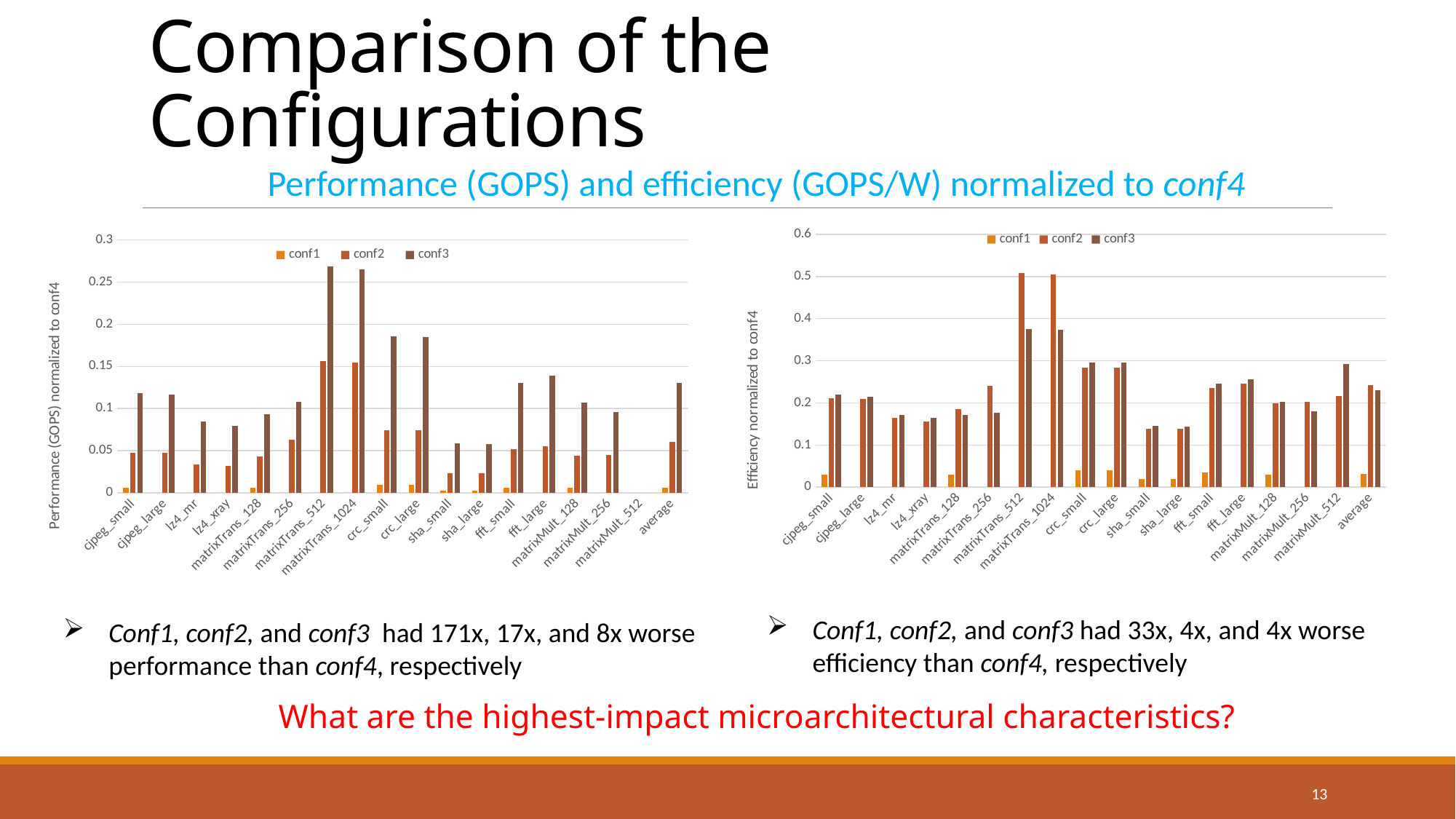
How many series does the legend of the right chart (Efficiency normalized to conf4) list? 3 What is the y-axis title of the right chart? Efficiency normalized to conf4 In the right chart (Efficiency normalized to conf4), is the conf3 value for sha_small greater or less than 0.2? less In the left chart (Performance normalized to conf4), which is larger for crc_small: conf2 or conf3? conf3 What kind of chart is the left chart (Performance normalized to conf4)? bar chart In the right chart (Efficiency normalized to conf4), which series has the lowest bars across the categories? conf1 What is the subtitle shown above the two charts? Performance (GOPS) and efficiency (GOPS/W) normalized to conf4 How many categories are shown on the x axis of the left chart (Performance normalized to conf4)? 18 In the right chart (Efficiency normalized to conf4), is the conf2 value for matrixTrans_512 greater or less than 0.4? greater In the left chart (Performance normalized to conf4), is the conf3 value for matrixTrans_512 greater or less than 0.25? greater In the right chart (Efficiency normalized to conf4), which is larger for matrixTrans_512: conf2 or conf3? conf2